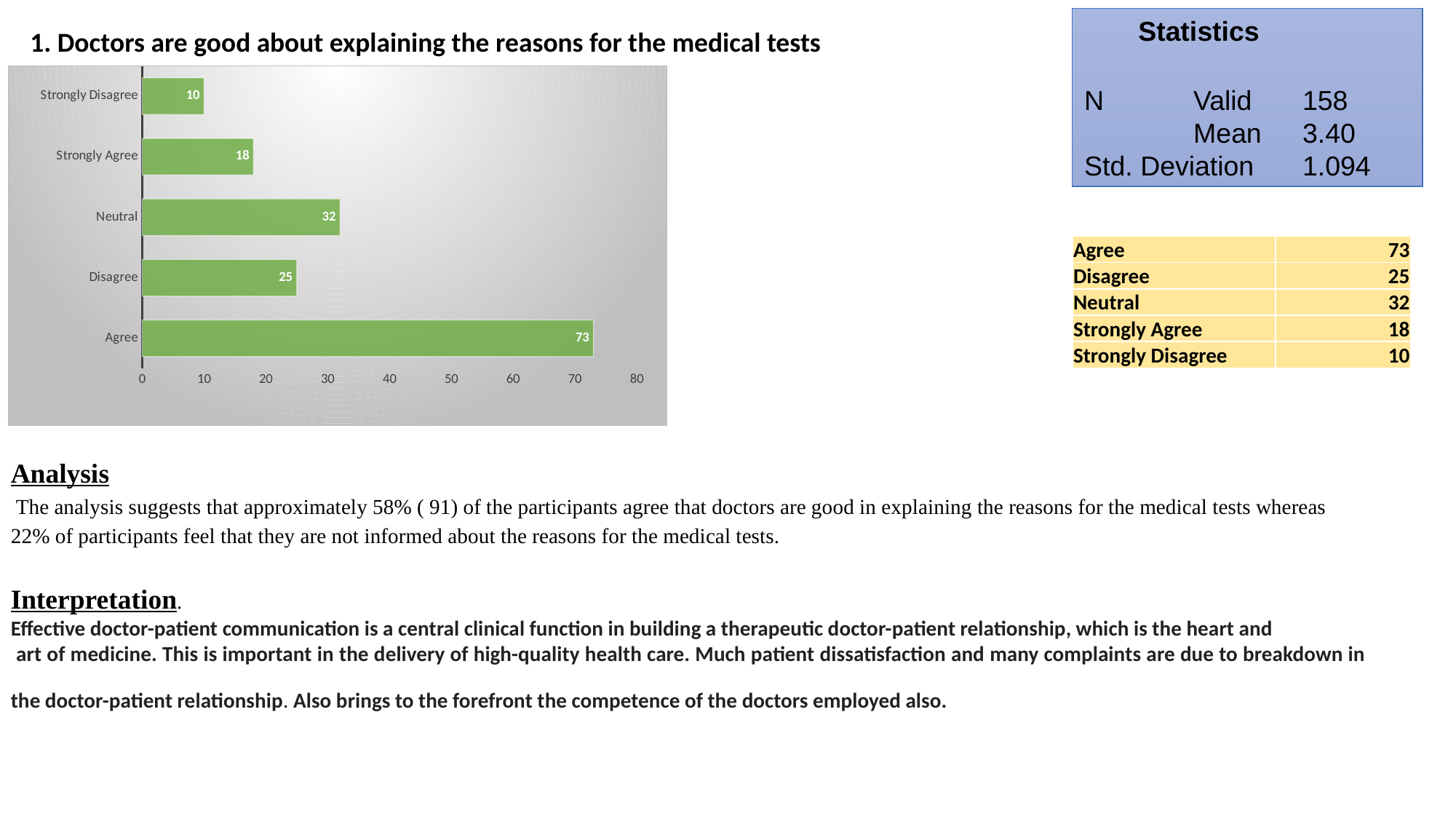
How many categories are shown in the chart? 5 What is the value for Agree? 73 What kind of chart is shown on the slide? bar chart What is the difference between the values for Agree and Neutral? 41 Which category has the highest value? Agree Which is larger, the value for Neutral or the value for Disagree? Neutral Which category has the lowest value? Strongly Disagree What is the value for Strongly Disagree? 10 What is the value for Neutral? 32 Is the value for Agree greater or less than 70? greater What is the title of the chart? 1. Doctors are good about explaining the reasons for the medical tests What is the difference between the values for Disagree and Strongly Agree? 7